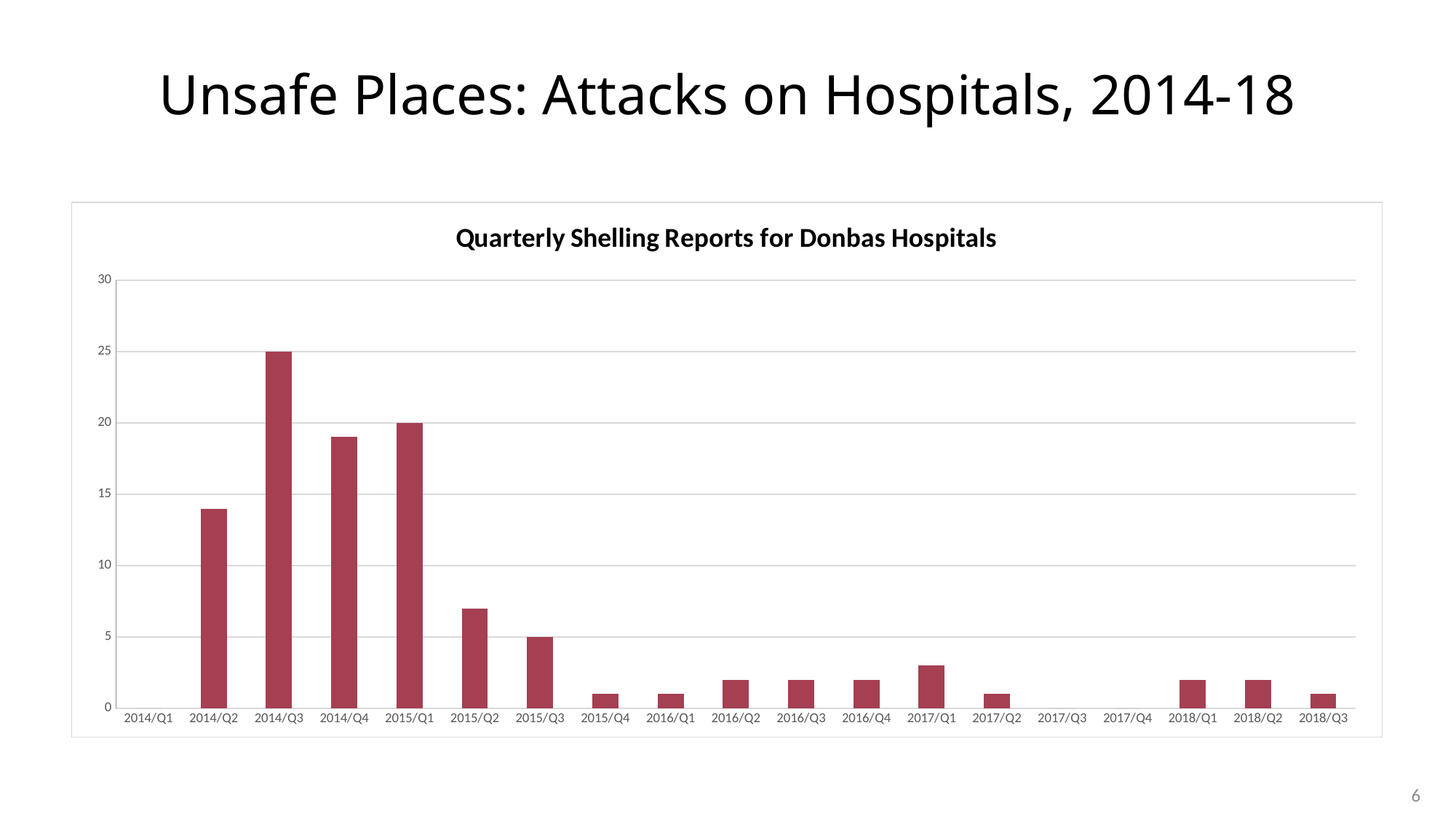
What kind of chart is shown on the slide? bar chart What is the value for 2015/Q1? 20 Which is larger, the value for 2014/Q2 or the value for 2014/Q4? 2014/Q4 What is the difference between the values for 2014/Q3 and 2015/Q1? 5 What is the value for 2014/Q3? 25 What is the value for 2015/Q3? 5 Do the values generally rise or fall from 2014/Q3 to 2018/Q3? fall Is the value for 2015/Q2 greater or less than 5? greater Which quarter has the highest number of shelling reports? 2014/Q3 Is the value for 2014/Q2 greater or less than 15? less How many quarters are shown on the x axis of the chart? 19 What is the title of the chart? Quarterly Shelling Reports for Donbas Hospitals